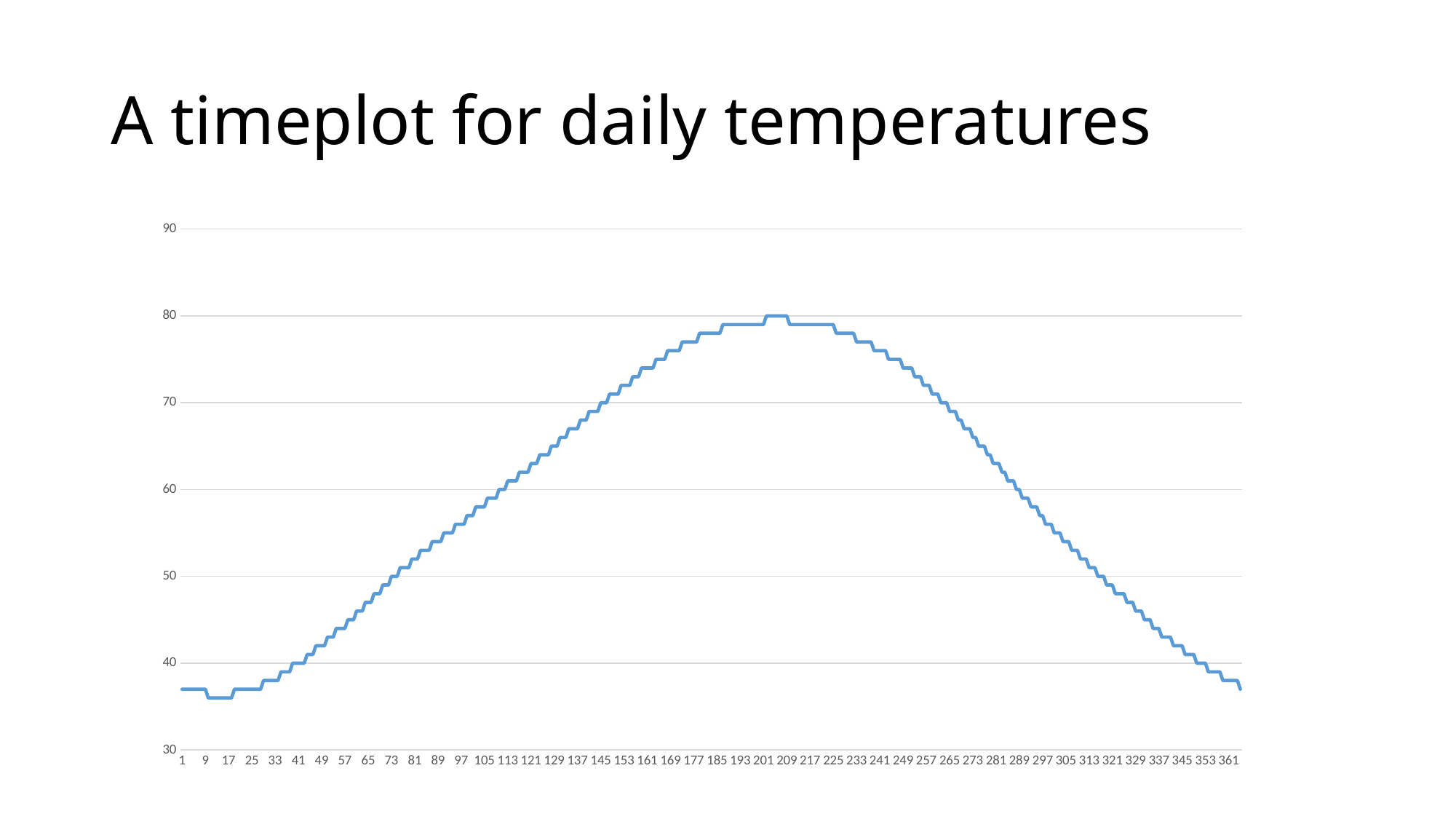
Is the value at x = 97 greater or less than 60? less Is the value at x = 201 greater or less than 70? greater What are the lowest and highest values labelled on the y axis? 30 and 90 What is the highest value the line reaches, as read against the y-axis gridlines? 80 Which is larger, the value at x = 89 or the value at x = 273? x = 273 What kind of chart is shown on the slide? line chart Is the value at x = 273 greater or less than 60? greater What is the title of the slide? A timeplot for daily temperatures Does the line rise or fall along the x axis between 209 and 361? fall Does the line rise or fall along the x axis between 1 and 201? rise